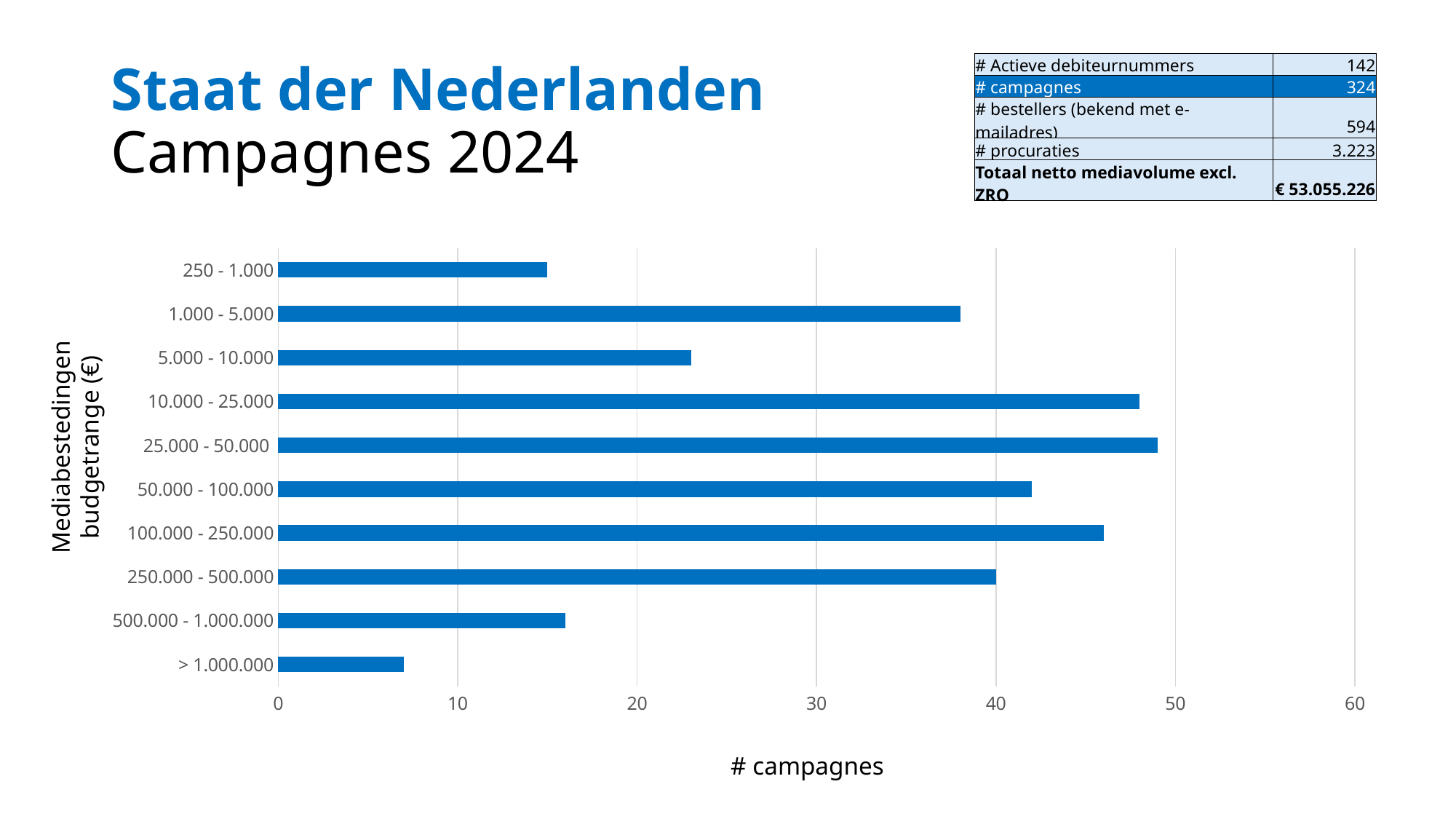
How many budget range categories are plotted in the chart? 10 Is the value for 1.000 - 5.000 greater or less than 30? greater Is the value for 5.000 - 10.000 greater or less than 30? less Which has more campagnes: 100.000 - 250.000 or 50.000 - 100.000? 100.000 - 250.000 Which budget range has the lowest number of campagnes? > 1.000.000 Is the value for > 1.000.000 greater or less than 10? less What kind of chart is shown on the slide? bar chart What is the title of the horizontal axis of the chart? # campagnes What is the title of the vertical axis of the chart? Mediabestedingen budgetrange (€) Which has more campagnes: 1.000 - 5.000 or 5.000 - 10.000? 1.000 - 5.000